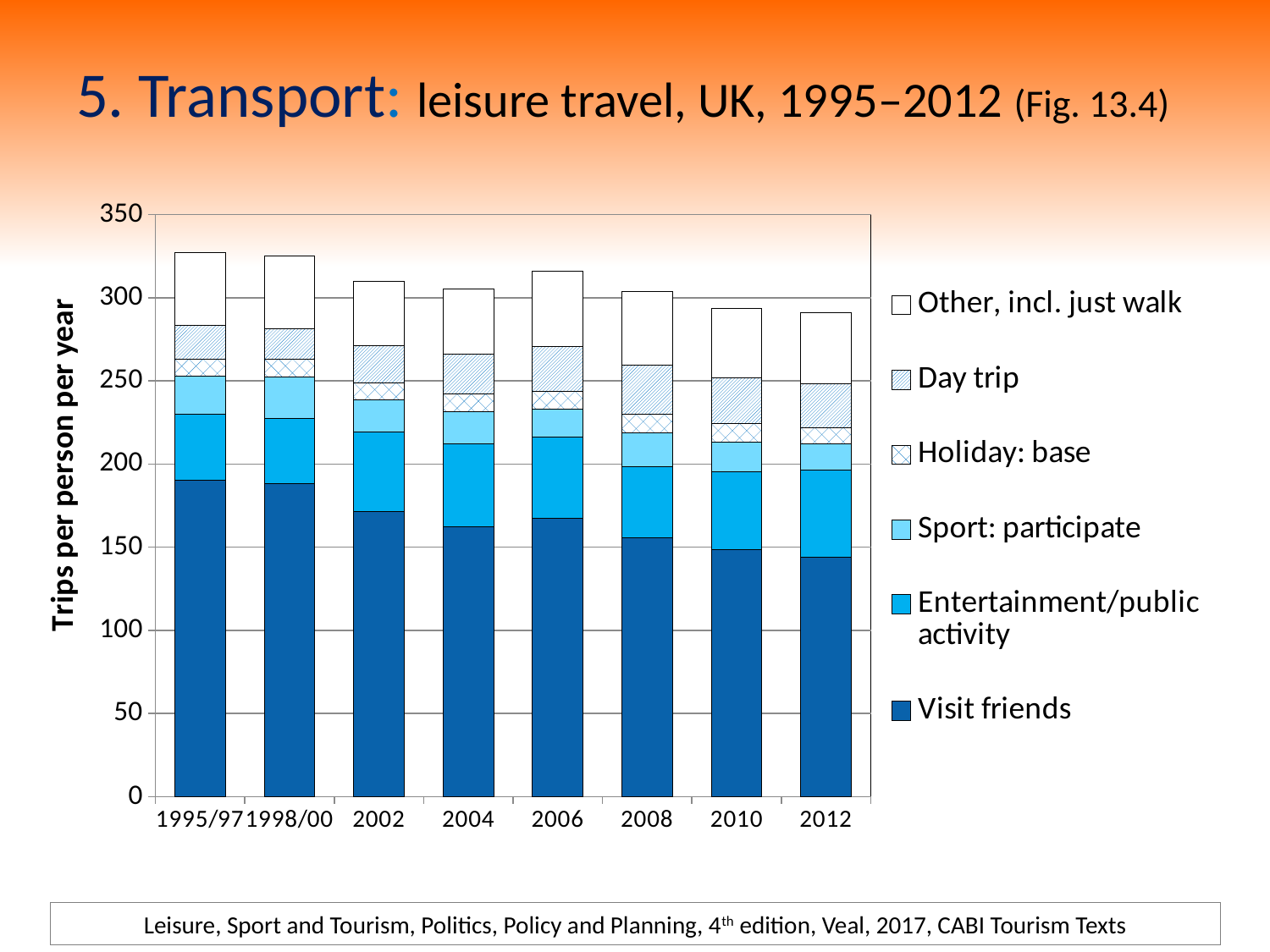
Is the value for Visit friends in 2012 greater or less than 150? less Is the total height of the stacked bar for 1995/97 greater or less than 300? greater How many series does the legend list? 6 Which series is shown at the bottom of each stacked bar? Visit friends Which is larger, the Visit friends value for 1995/97 or for 2012? 1995/97 What kind of chart is shown on the slide? Stacked bar chart Does the Visit friends value generally rise or fall from 1995/97 to 2012? fall Is the value for Visit friends in 2002 greater or less than 150? greater What is the label on the vertical axis? Trips per person per year How many time periods are shown along the x axis? 8